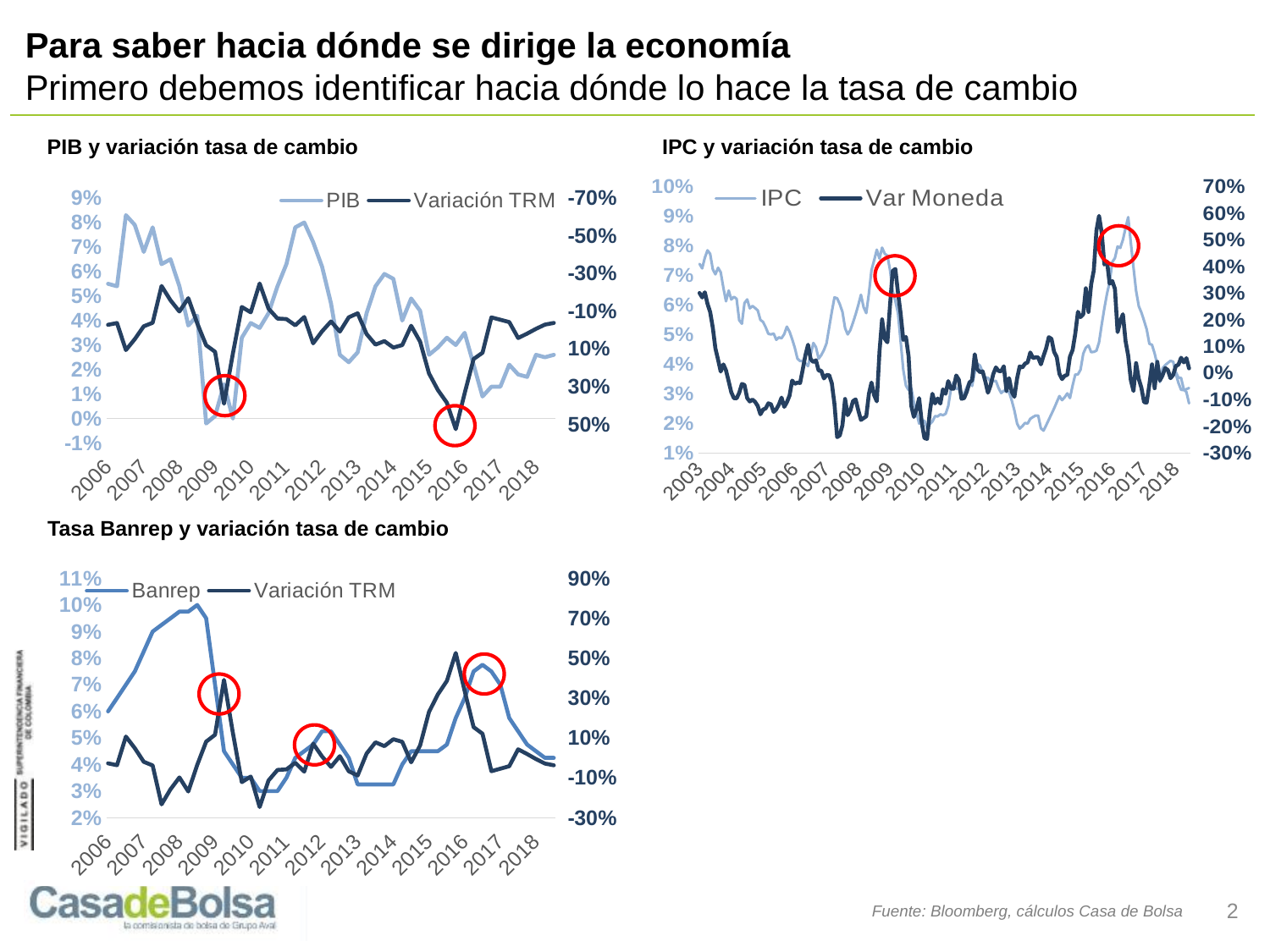
In the 'PIB y variación tasa de cambio' chart, is the PIB value at 2007 greater or less than 6%? greater How many year labels are shown on the x axis of the 'IPC y variación tasa de cambio' chart? 16 How many year labels are shown on the x axis of the 'PIB y variación tasa de cambio' chart? 13 In the 'IPC y variación tasa de cambio' chart, does the IPC series rise or fall between 2016 and 2018? fall In the 'Tasa Banrep y variación tasa de cambio' chart, does the Banrep series rise or fall between 2006 and 2008? rise How many series does the legend of the 'IPC y variación tasa de cambio' chart list? 2 In the 'IPC y variación tasa de cambio' chart, is the IPC value at 2018 greater or less than 5%? less In the 'Tasa Banrep y variación tasa de cambio' chart, is the Banrep value at 2008 greater or less than 8%? greater What kind of chart is the 'PIB y variación tasa de cambio' chart? Line chart What are the two series named in the legend of the 'Tasa Banrep y variación tasa de cambio' chart? Banrep and Variación TRM